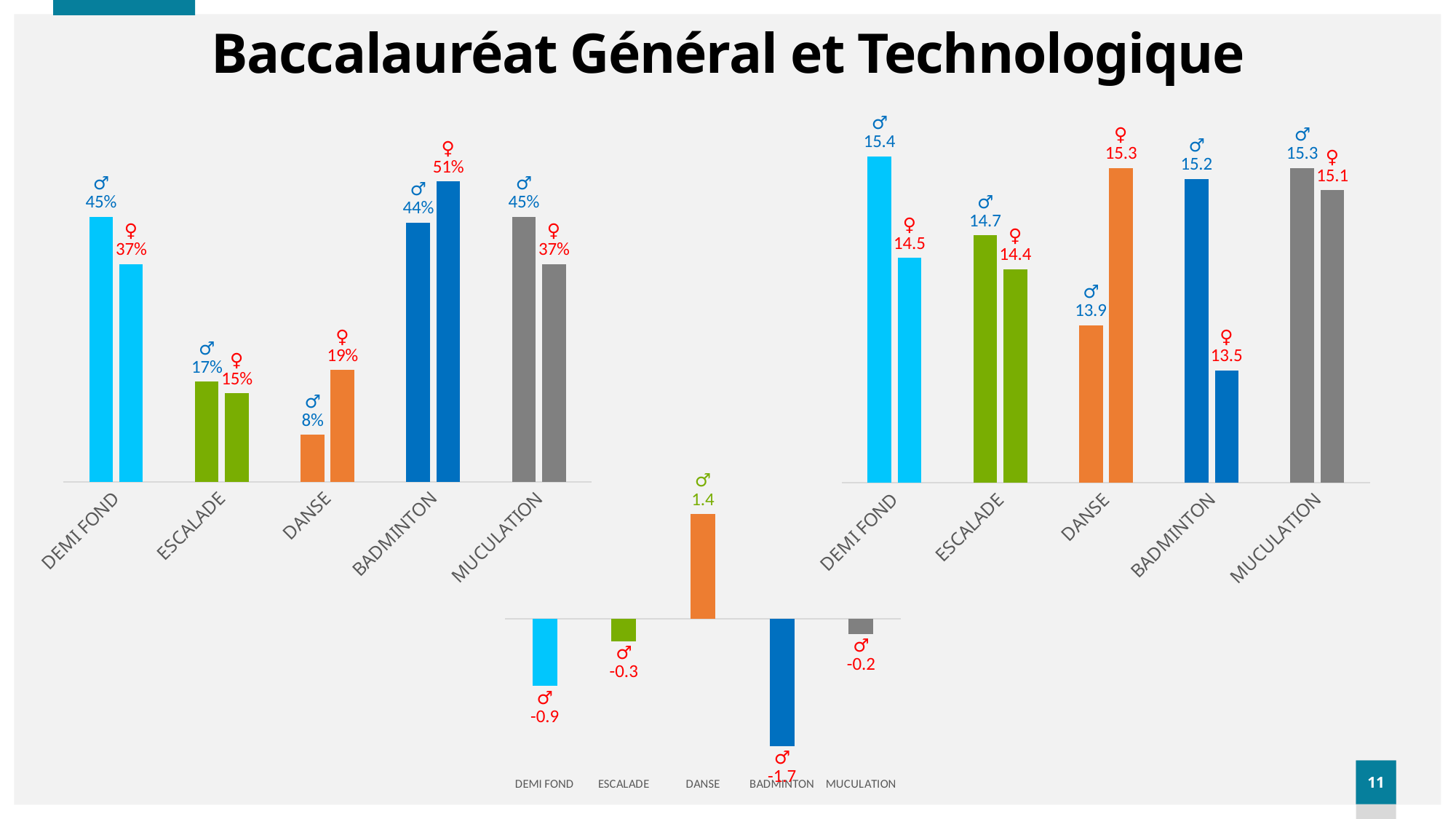
In the right chart, what is the female (♀) value for BADMINTON? 13.5 How many categories are shown on the x axis of the left chart? 5 In the right chart, what is the difference between the male (♂) and female (♀) values for ESCALADE? 0.3 In the bottom centre chart, what is the value for BADMINTON? -1.7 What kind of chart is the bottom centre chart? bar chart In the bottom centre chart, which category has the lowest value? BADMINTON In the right chart, what is the male (♂) value for DEMI FOND? 15.4 In the left chart, what is the male (♂) value for DANSE? 8% In the left chart, what is the female (♀) value for BADMINTON? 51% In the right chart, which is larger for DANSE, the male (♂) value or the female (♀) value? female (♀), 15.3 In the left chart, what is the difference between the female (♀) and male (♂) values for DANSE? 11% In the bottom centre chart, which category has the highest value? DANSE